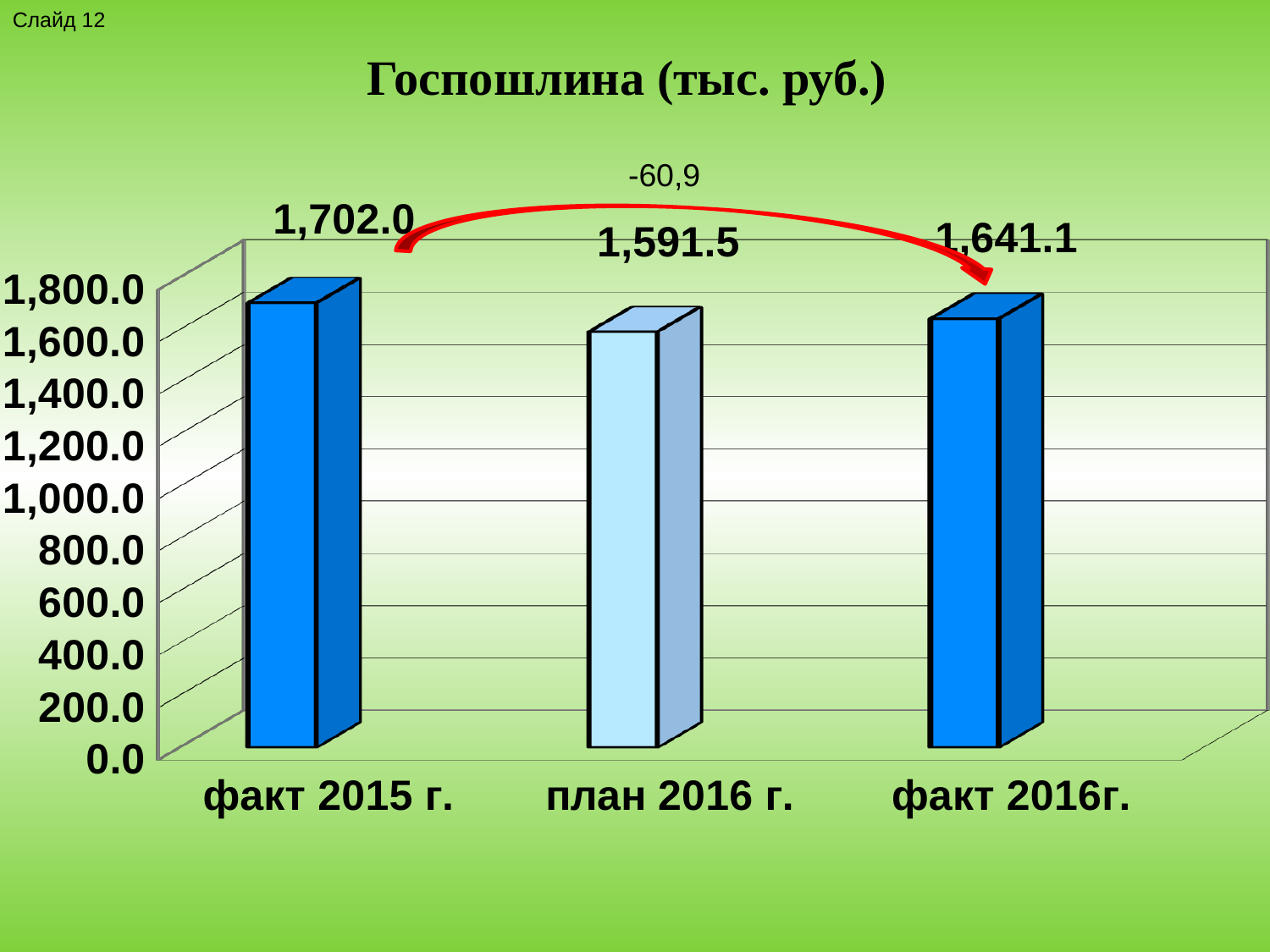
What is the value for факт 2015 г.? 1,702.0 How many categories are shown on the chart? 3 What is the difference between факт 2015 г. and факт 2016г.? 60.9 Which category has the lowest value? план 2016 г. What is the title of the chart? Госпошлина (тыс. руб.) What kind of chart is shown? bar chart What is the value for факт 2016г.? 1,641.1 Which is larger, факт 2016г. or план 2016 г.? факт 2016г. Is the value for план 2016 г. greater or less than 1,600.0? less Which category has the highest value? факт 2015 г. What is the value for план 2016 г.? 1,591.5 What is the difference between факт 2016г. and план 2016 г.? 49.6